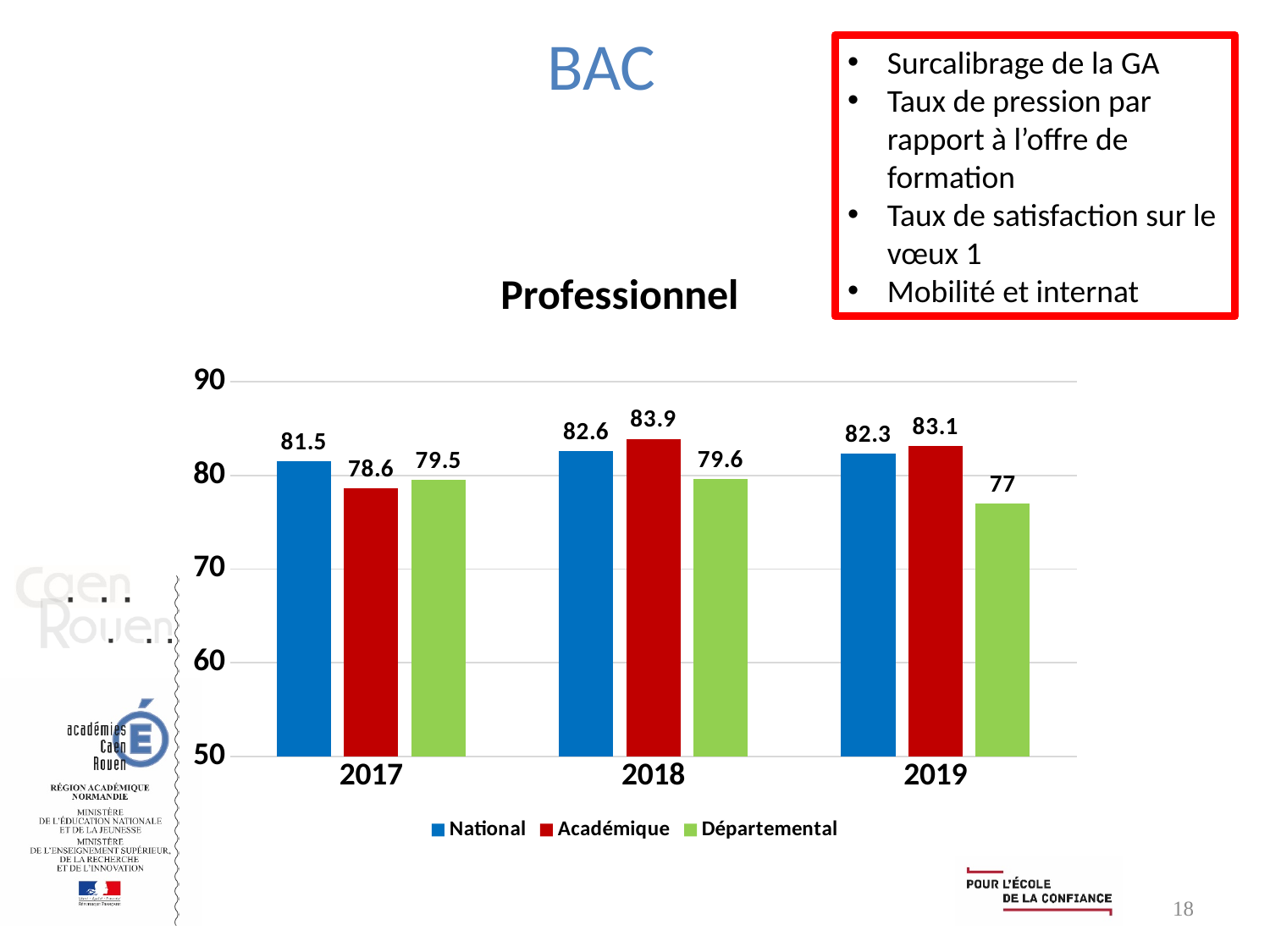
How many years are shown on the x axis? 3 What is the Académique value for 2017? 78.6 Which year has the highest Académique value? 2018 What is the National value for 2018? 82.6 In 2017, which is larger: the National value or the Académique value? National What is the Départemental value for 2019? 77 What is the title of the chart? Professionnel What is the difference between the Académique and Départemental values in 2019? 6.1 Which year has the lowest Départemental value? 2019 How many series does the legend list? 3 What kind of chart is shown on the slide? Bar chart Does the Départemental value rise or fall from 2018 to 2019? Fall